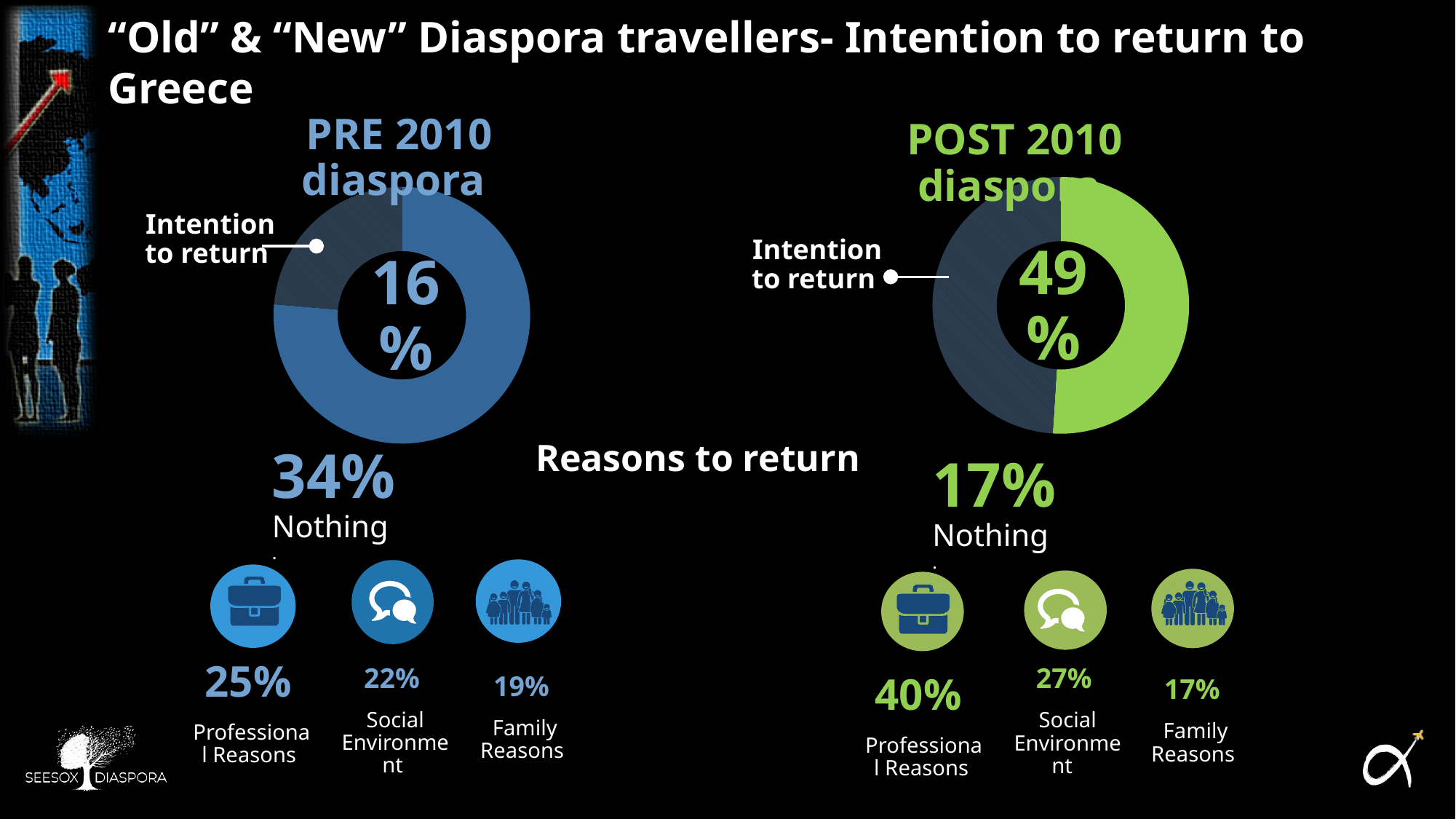
In the POST 2010 diaspora chart, is the intention-to-return slice greater or less than a quarter of the donut? greater Which group has the higher intention to return, PRE 2010 diaspora or POST 2010 diaspora? POST 2010 diaspora In the POST 2010 diaspora chart, what percentage is shown for intention to return? 49% What colour is the intention-to-return slice in the POST 2010 diaspora chart? Green Under Reasons to return, what percentage of the PRE 2010 diaspora cite Professional Reasons? 25% What kind of chart is used to show intention to return for the PRE 2010 diaspora? Donut (pie) chart What is the difference in intention to return between the POST 2010 and PRE 2010 diaspora charts? 33 percentage points Under Reasons to return, what percentage of the POST 2010 diaspora cite Social Environment? 27% In the PRE 2010 diaspora chart, is the intention-to-return slice greater or less than half of the donut? less In the PRE 2010 diaspora chart, what percentage is shown for intention to return? 16% How many donut charts are shown on the slide? 2 Under Reasons to return, which reason has the highest percentage for the POST 2010 diaspora? Professional Reasons